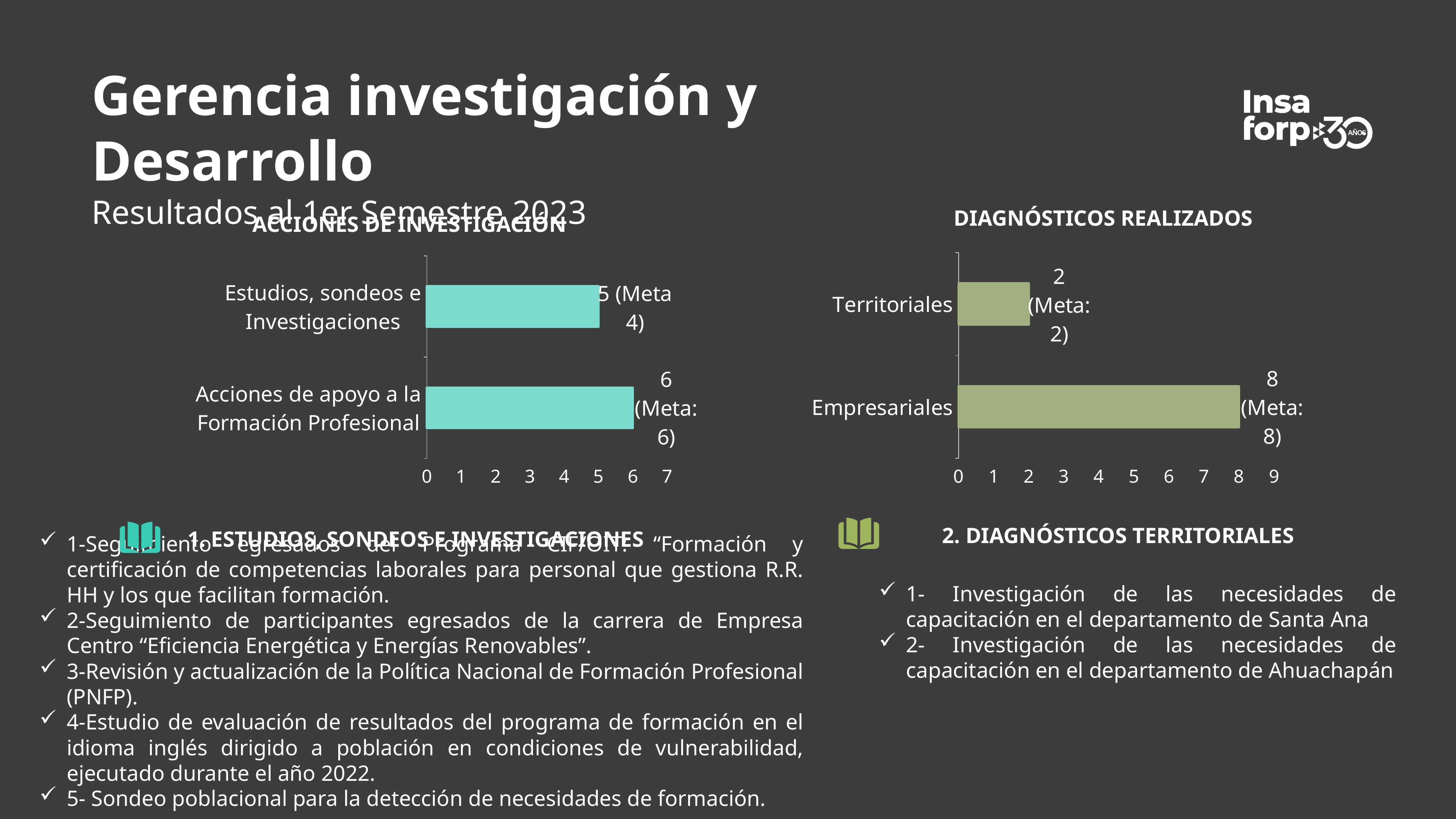
In the DIAGNÓSTICOS REALIZADOS chart, which category has the lowest value? Territoriales In the DIAGNÓSTICOS REALIZADOS chart, what is the highest value shown on the x axis? 9 In the DIAGNÓSTICOS REALIZADOS chart, what is the value for Territoriales? 2 In the ACCIONES DE INVESTIGACIÓN chart, what is the Meta shown for Estudios, sondeos e Investigaciones? 4 What kind of chart is the DIAGNÓSTICOS REALIZADOS chart? Bar chart How many categories are shown in the ACCIONES DE INVESTIGACIÓN chart? 2 In the DIAGNÓSTICOS REALIZADOS chart, what is the difference between the values for Empresariales and Territoriales? 6 In the DIAGNÓSTICOS REALIZADOS chart, what is the value for Empresariales? 8 In the ACCIONES DE INVESTIGACIÓN chart, what is the difference between the values for Acciones de apoyo a la Formación Profesional and Estudios, sondeos e Investigaciones? 1 In the ACCIONES DE INVESTIGACIÓN chart, what is the value for Estudios, sondeos e Investigaciones? 5 In the ACCIONES DE INVESTIGACIÓN chart, which category has the higher value? Acciones de apoyo a la Formación Profesional In the ACCIONES DE INVESTIGACIÓN chart, what is the value for Acciones de apoyo a la Formación Profesional? 6